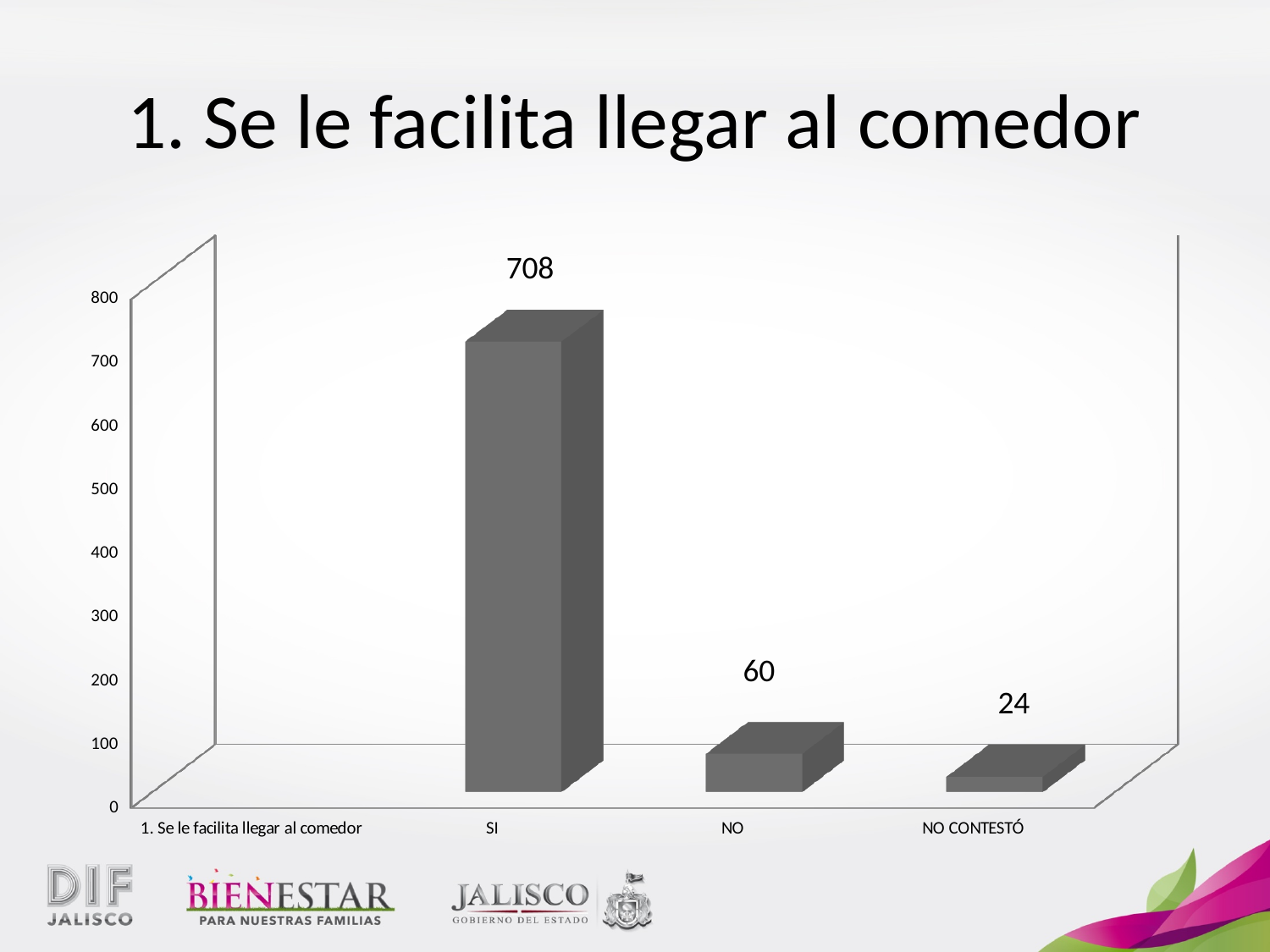
What is the difference between the values for SI and NO? 648 What is the difference between the values for NO and NO CONTESTÓ? 36 How many bars are plotted on the chart? 3 Which is larger, the value for NO or the value for NO CONTESTÓ? NO Is the value for NO greater or less than 100? less What kind of chart is shown on the slide? bar chart What is the value for NO? 60 Is the value for SI greater or less than 500? greater What is the value for SI? 708 Which category has the highest value? SI What is the value for NO CONTESTÓ? 24 Which category has the lowest value? NO CONTESTÓ